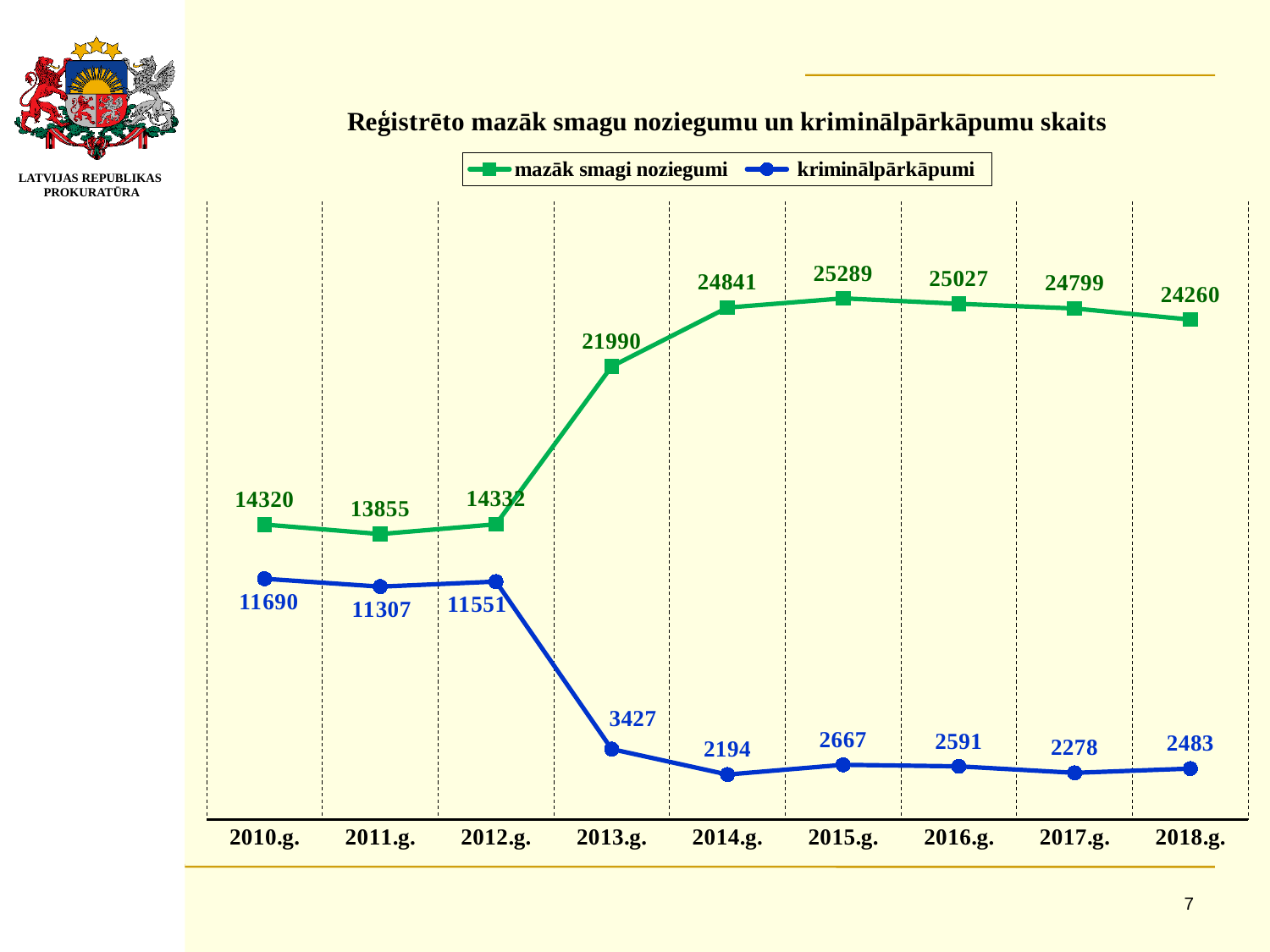
Does the kriminālpārkāpumi series rise or fall from 2012.g. to 2014.g.? fall How many series does the legend list? 2 What is the difference between mazāk smagi noziegumi and kriminālpārkāpumi in 2018.g.? 21777 What is the value for mazāk smagi noziegumi in 2015.g.? 25289 What is the value for kriminālpārkāpumi in 2013.g.? 3427 What colour is the line for kriminālpārkāpumi? blue Which is larger: mazāk smagi noziegumi in 2013.g. or in 2012.g.? 2013.g. What is the value for kriminālpārkāpumi in 2010.g.? 11690 In which year is the mazāk smagi noziegumi series highest? 2015.g. In which year is the kriminālpārkāpumi series lowest? 2014.g. How many years are shown on the x axis? 9 What kind of chart is shown on the slide? line chart